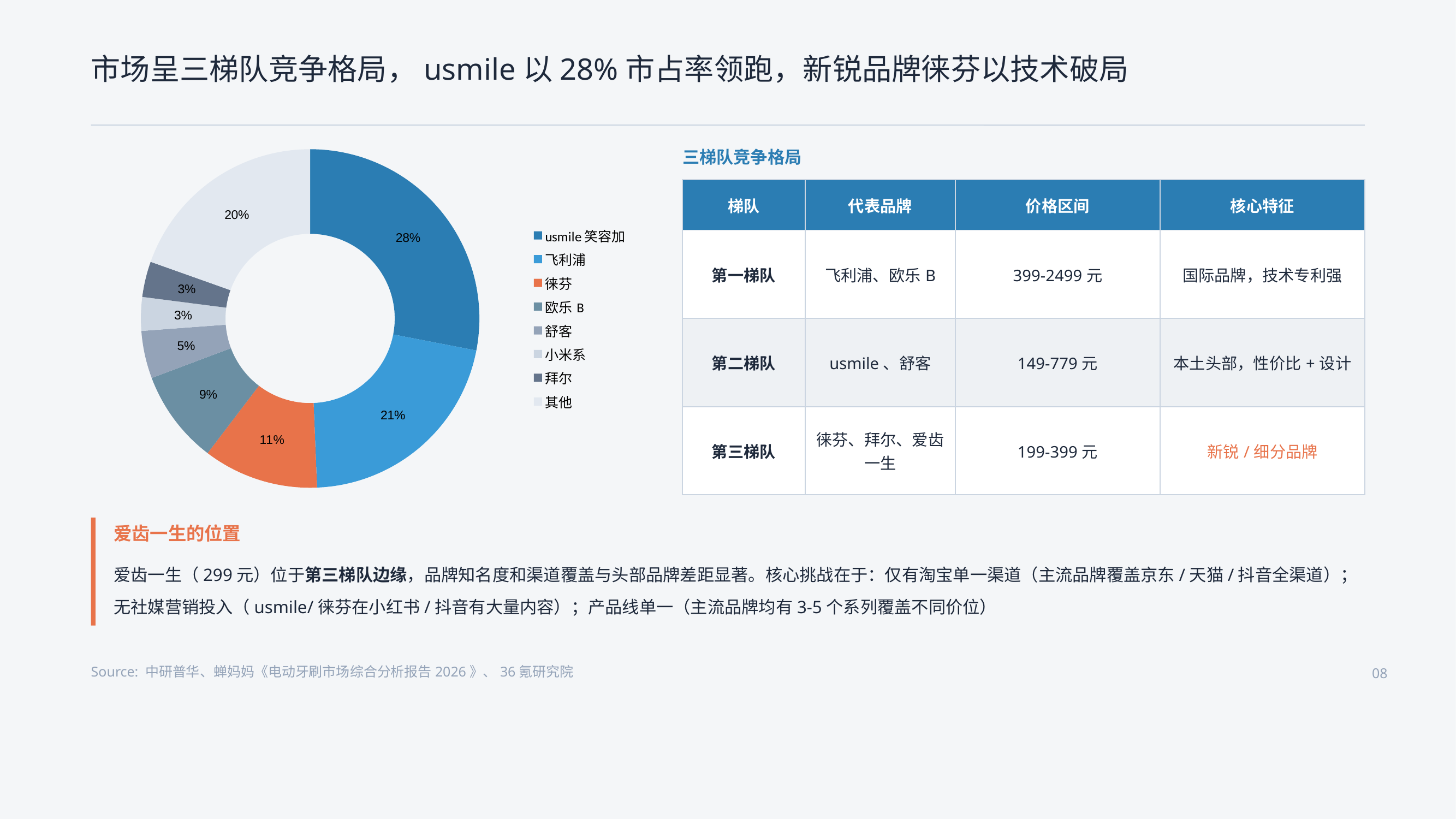
What is the difference in share between 徕芬 and 欧乐 B? 2% What is the difference in share between usmile 笑容加 and 飞利浦? 7% What share of the market does usmile 笑容加 hold in the donut chart? 28% What type of chart is used to show the market shares? Donut (pie) chart What percentage does 徕芬 account for in the donut chart? 11% Which brand has the largest share in the donut chart? usmile 笑容加 Which legend entry is shown in orange in the donut chart? 徕芬 What is the share shown for 欧乐 B? 9% What share is shown for 其他 in the donut chart? 20% How many categories are listed in the donut chart's legend? 8 What is the market share shown for 飞利浦? 21% Which has a larger share, 舒客 or 欧乐 B? 欧乐 B